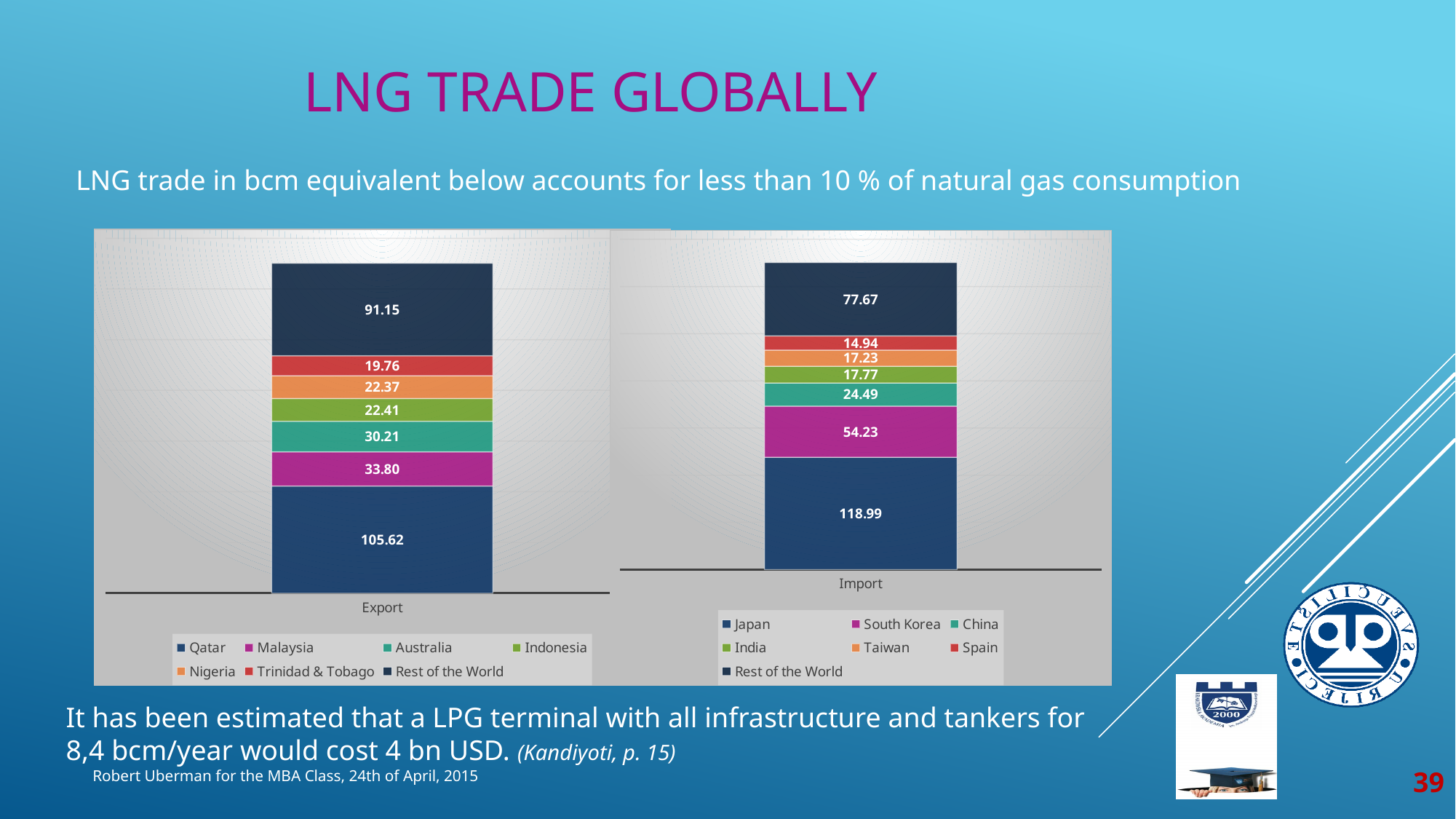
In the Export chart, what is the value for Trinidad & Tobago? 19.76 How many series does the legend of the Import chart list? 7 What is the total of the Export stacked bar? 325.32 In the Export chart, which country has the largest segment? Qatar In the Import chart, which country has the smallest segment? Spain In the Export chart, what is the value for Qatar? 105.62 In the Export chart, what is the difference between the Malaysia and Australia values? 3.59 What kind of chart is the Export chart? Stacked bar chart In the Import chart, what is the value for Japan? 118.99 In the Import chart, which is larger, the value for China or the value for India? China What is the total of the Import stacked bar? 325.32 In the Import chart, what is the value for South Korea? 54.23